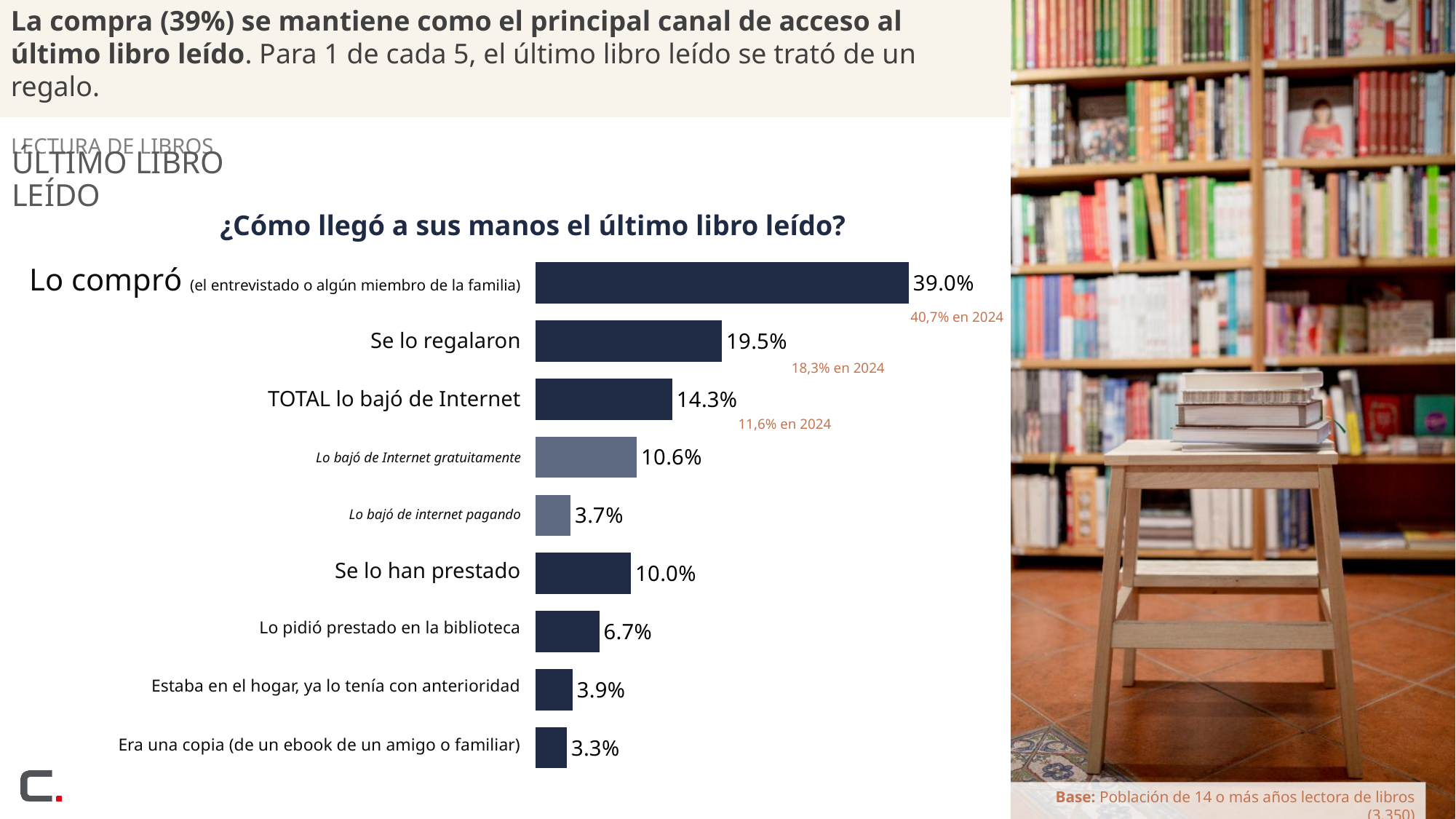
Which category has the highest value? Lo compró What is the value for "Lo bajó de Internet gratuitamente"? 10.6% What was the value for "Lo compró" in 2024, according to the annotation? 40,7% What is the value for "Lo pidió prestado en la biblioteca"? 6.7% What is the value for "Se lo regalaron"? 19.5% What is the title of the chart? ¿Cómo llegó a sus manos el último libro leído? Which is larger: "Se lo han prestado" or "Lo pidió prestado en la biblioteca"? Se lo han prestado Which category has the lowest value? Era una copia (de un ebook de un amigo o familiar) What kind of chart is shown? Bar chart What is the difference between "Lo compró" and "Se lo regalaron"? 19.5% How many categories (bars) does the chart show? 9 What is the difference between "TOTAL lo bajó de Internet" and "Se lo han prestado"? 4.3%